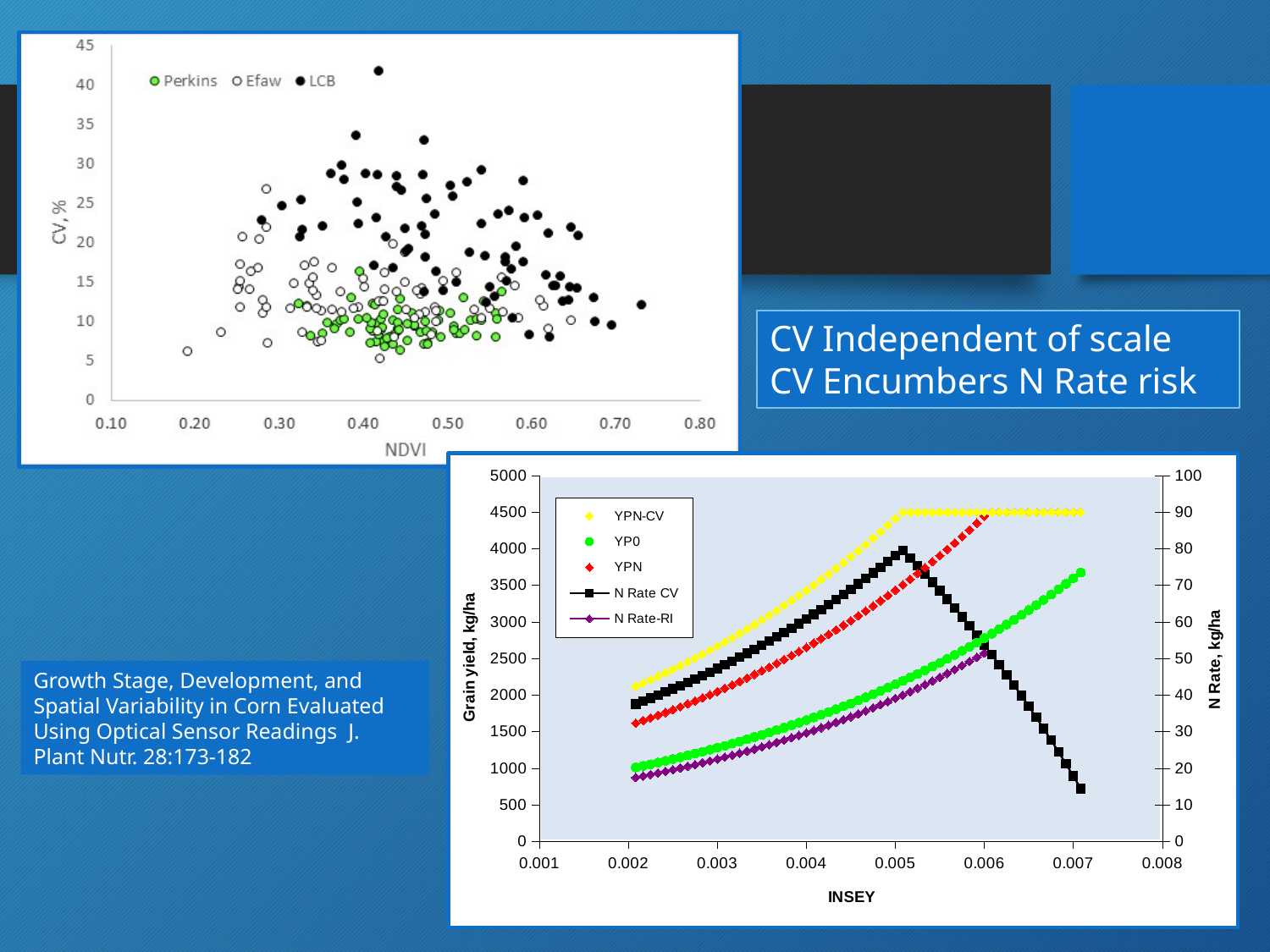
In the top-left chart, which series is shown with green filled markers? Perkins In the top-left chart, what is the label of the horizontal axis? NDVI In the bottom-right chart, does the YP0 series rise or fall as INSEY increases? rise In the top-left chart, is the highest LCB point greater or less than 40 on the CV, % axis? greater How many series does the legend of the top-left chart (CV, % vs NDVI) list? 3 In the bottom-right chart, is the N Rate-RI value at INSEY 0.002 greater or less than 20 on the N Rate axis? less In the bottom-right chart, what is the title of the right-hand vertical axis? N Rate, kg/ha In the bottom-right chart, at what grain yield value does the YPN-CV series level off? 4500 In the bottom-right chart, at INSEY 0.004, which series is higher: YPN-CV or YP0? YPN-CV What kind of chart is the top-left chart with CV, % on the vertical axis? scatter plot In the bottom-right chart, is the YP0 value at INSEY 0.007 greater or less than 3000 kg/ha? greater How many series does the legend of the bottom-right chart (Grain yield vs INSEY) list? 5